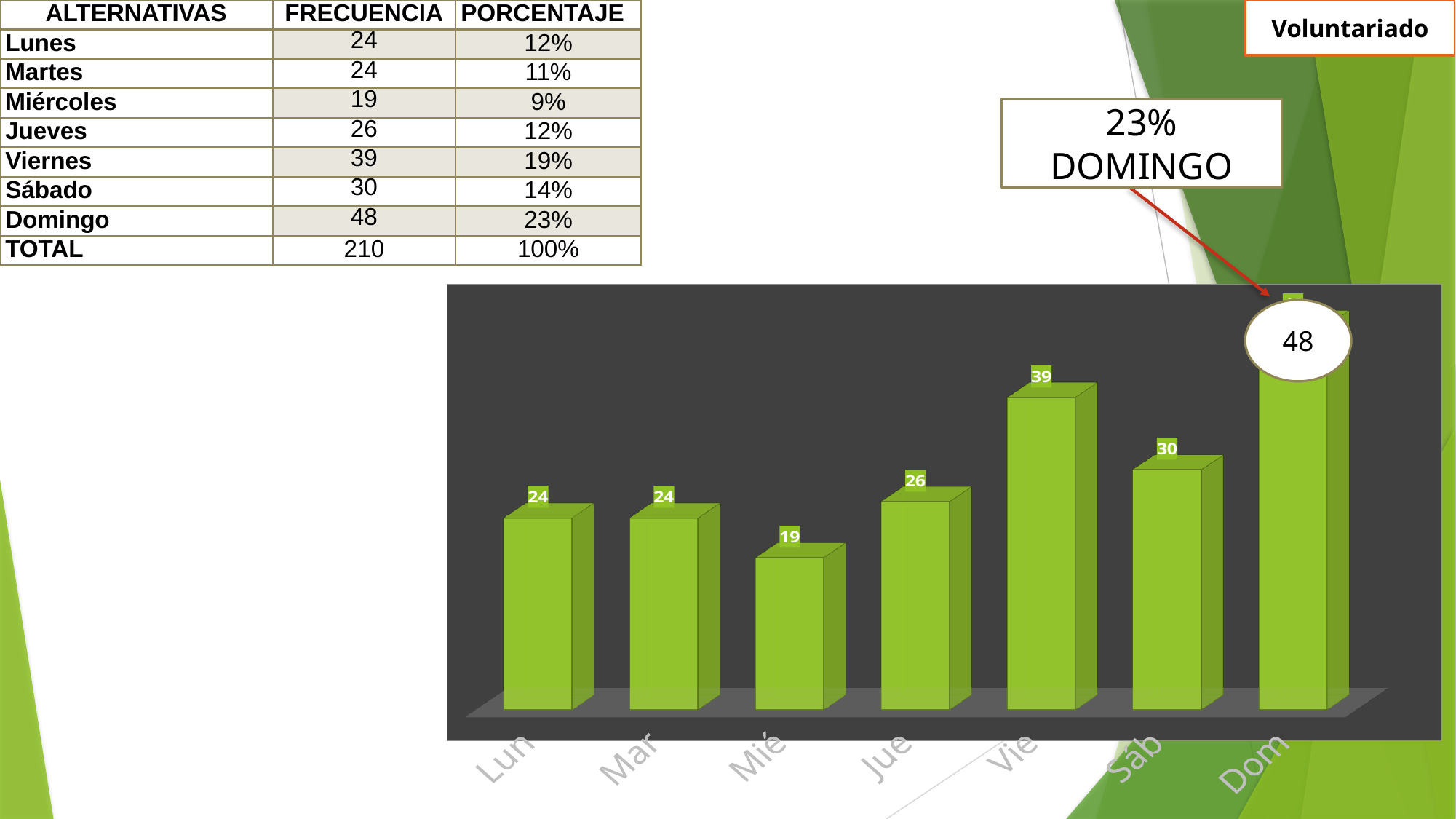
Which category has the lowest value in the bar chart? Mié What percentage does the callout box on the slide give for DOMINGO? 23% What kind of chart is shown on the slide? Bar chart What is the difference between the values for Dom and Vie? 9 What is the difference between the values for Sáb and Mié? 11 What is the value for Vie in the bar chart? 39 What is the value for Jue in the bar chart? 26 What is the value for Mié in the bar chart? 19 Which is larger, the value for Vie or the value for Sáb? Vie What is the value for Sáb in the bar chart? 30 How many categories are shown on the x axis of the bar chart? 7 Which category has the highest value in the bar chart? Dom